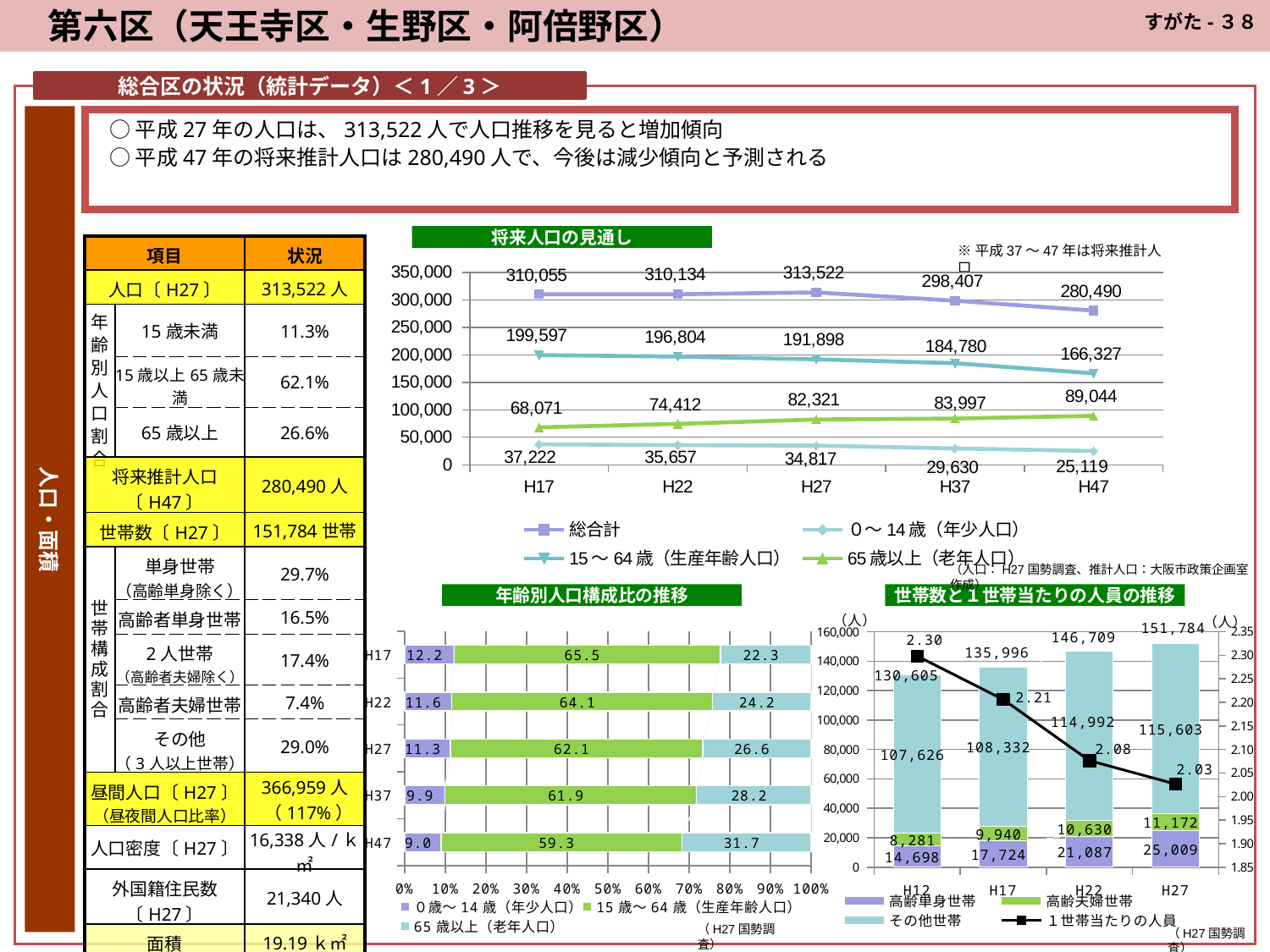
「将来人口の見通し」のグラフで、総合計が最も高いのはどの年ですか？ H27 「年齢別人口構成比の推移」のグラフはどの種類のグラフですか？ 積み上げ横棒グラフ 「将来人口の見通し」のグラフで、H17からH47にかけて0～14歳（年少人口）は増加していますか、減少していますか？ 減少 「年齢別人口構成比の推移」のグラフで、H17の15～64歳（生産年齢人口）の割合はいくつですか？ 65.5 「年齢別人口構成比の推移」のグラフで、H47の65歳以上（老年人口）の割合はいくつですか？ 31.7 「世帯数と１世帯当たりの人員の推移」のグラフで、H22の高齢単身世帯の値はいくつですか？ 21,087 「世帯数と１世帯当たりの人員の推移」のグラフで、H27の１世帯当たりの人員はいくつですか？ 2.03 「将来人口の見通し」のグラフで、H27の総合計とH47の総合計の差はいくつですか？ 33,032 「将来人口の見通し」のグラフで、H27の総合計の値はいくつですか？ 313,522 「将来人口の見通し」のグラフで、H47の65歳以上（老年人口）の値はいくつですか？ 89,044 「世帯数と１世帯当たりの人員の推移」のグラフで、H12の世帯数の合計はいくつですか？ 130,605 「将来人口の見通し」のグラフの凡例には何系列ありますか？ 4